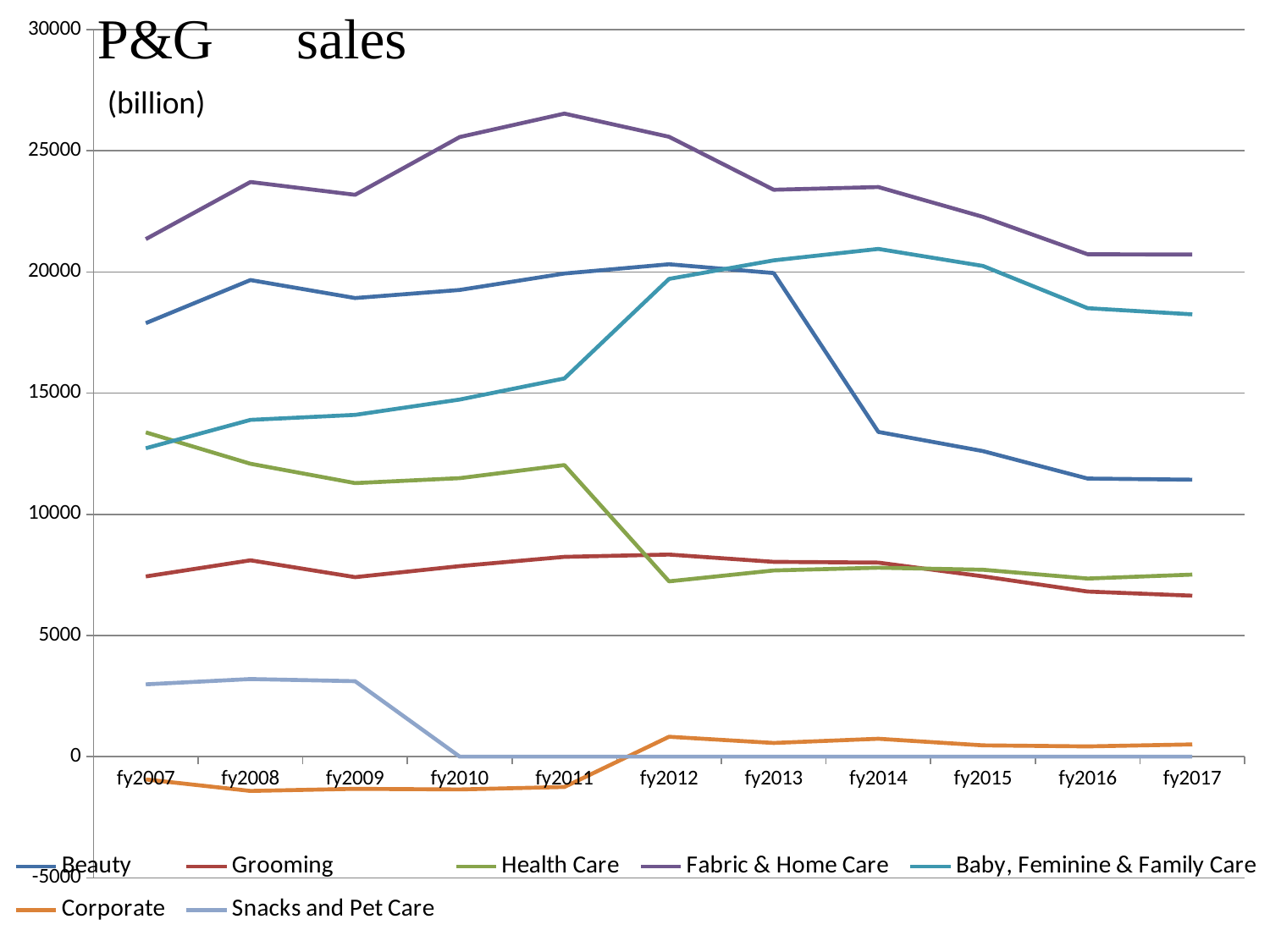
Is the value for Beauty in fy2017 greater or less than 15000? less In fy2017, which is larger: Baby, Feminine & Family Care or Beauty? Baby, Feminine & Family Care What kind of chart is shown on the slide? line chart In fy2010, which is larger: Health Care or Grooming? Health Care How many fiscal years are plotted along the x axis? 11 Does the Beauty series rise or fall from fy2012 to fy2017? fall Is the value for Fabric & Home Care in fy2011 greater or less than 25000? greater What is the title of the chart? P&G sales How many series does the legend list? 7 Which series has the lowest value in fy2009? Corporate Is the value for Health Care in fy2012 greater or less than 10000? less Which series has the highest value in fy2011? Fabric & Home Care